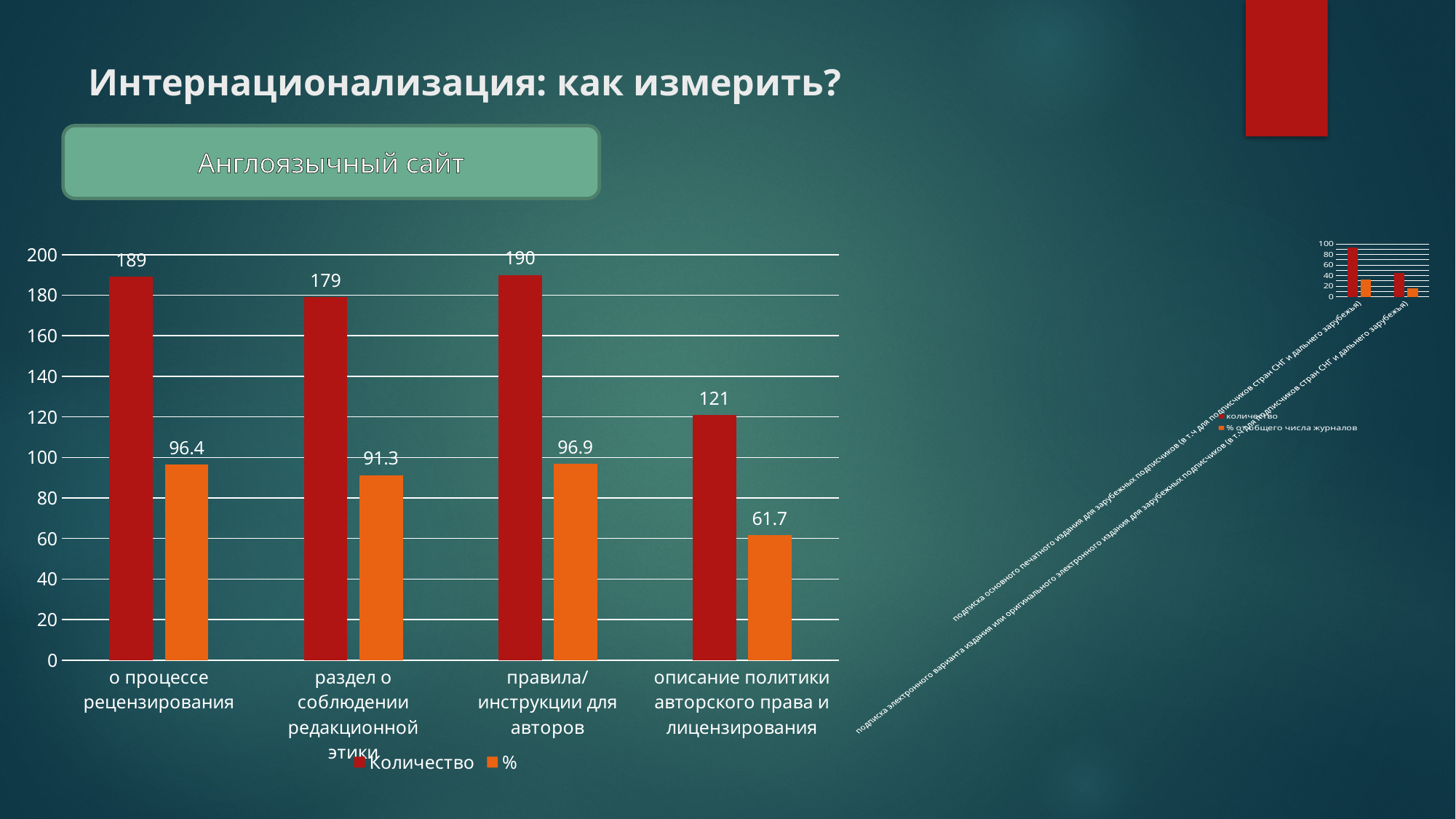
What kind of chart is the large chart on the left? bar chart In the large chart on the left, which category has the lowest Количество value? описание политики авторского права и лицензирования In the large chart on the left, what is the % value for «раздел о соблюдении редакционной этики»? 91.3 In the large chart on the left, which category has the highest % value? правила/инструкции для авторов In the large chart on the left, is the Количество value for «описание политики авторского права и лицензирования» greater or less than 140? less In the large chart on the left, which is larger: the Количество value for «о процессе рецензирования» or for «раздел о соблюдении редакционной этики»? о процессе рецензирования In the large chart on the left, what is the % value for «описание политики авторского права и лицензирования»? 61.7 In the large chart on the left, what is the difference between the Количество values for «о процессе рецензирования» and «описание политики авторского права и лицензирования»? 68 How many categories are shown on the x axis of the large chart on the left? 4 How many series does the legend of the large chart on the left list? 2 In the large chart on the left, what is the Количество value for «правила/инструкции для авторов»? 190 In the large chart on the left, what colour are the bars for the % series? orange